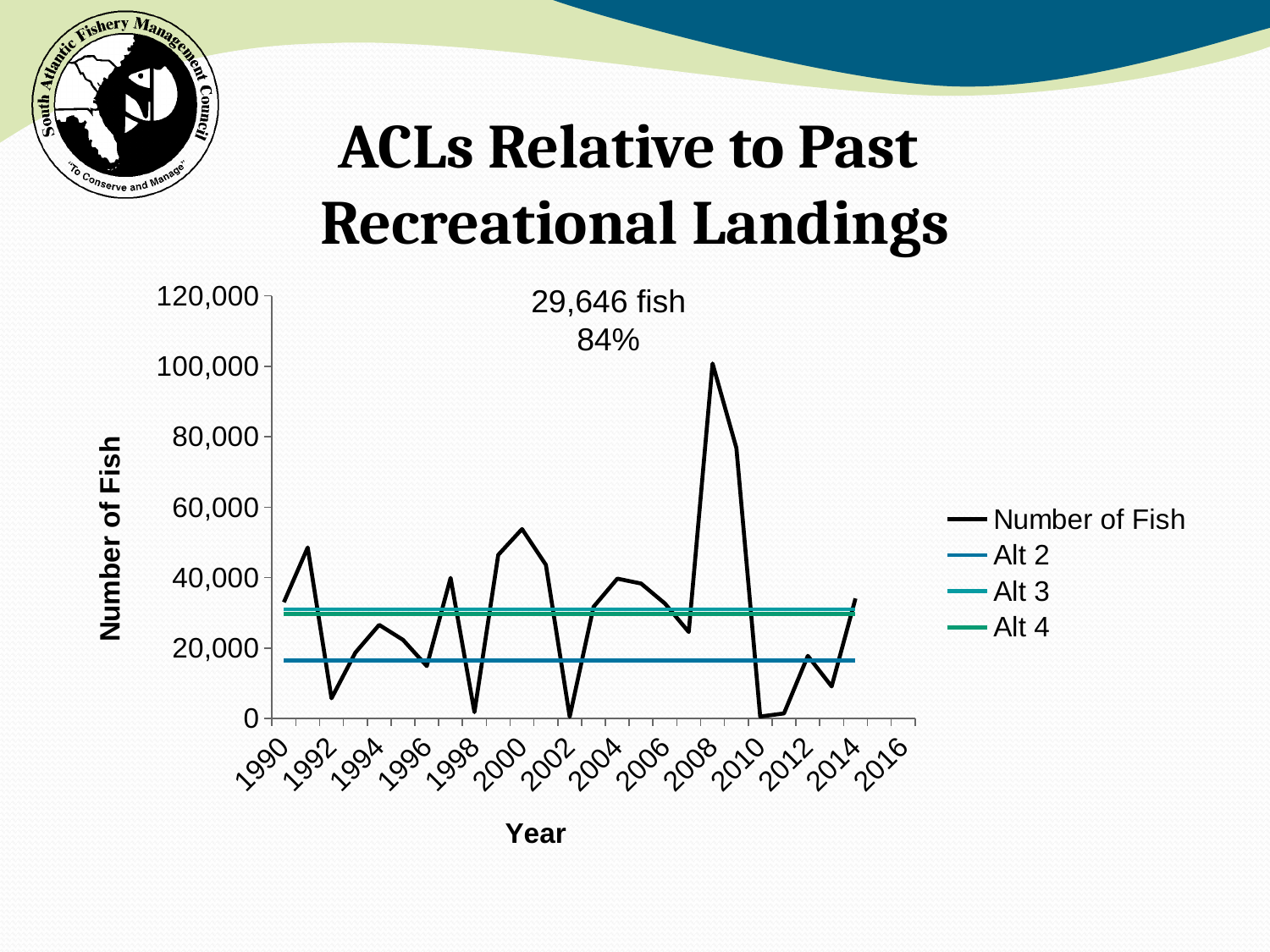
Is the Alt 3 line greater or less than 20,000? greater Which line is higher on the chart, Alt 2 or Alt 3? Alt 3 Is the Alt 2 line greater or less than 20,000? less Is the Number of Fish value for 2000 greater or less than 40,000? greater In which year does the Number of Fish series reach its highest value? 2008 What is the title of the chart? ACLs Relative to Past Recreational Landings What is the label on the vertical axis? Number of Fish What kind of chart is shown on the slide? line chart Which is larger, the Number of Fish value in 2009 or in 2000? 2009 How many series does the legend list? 4